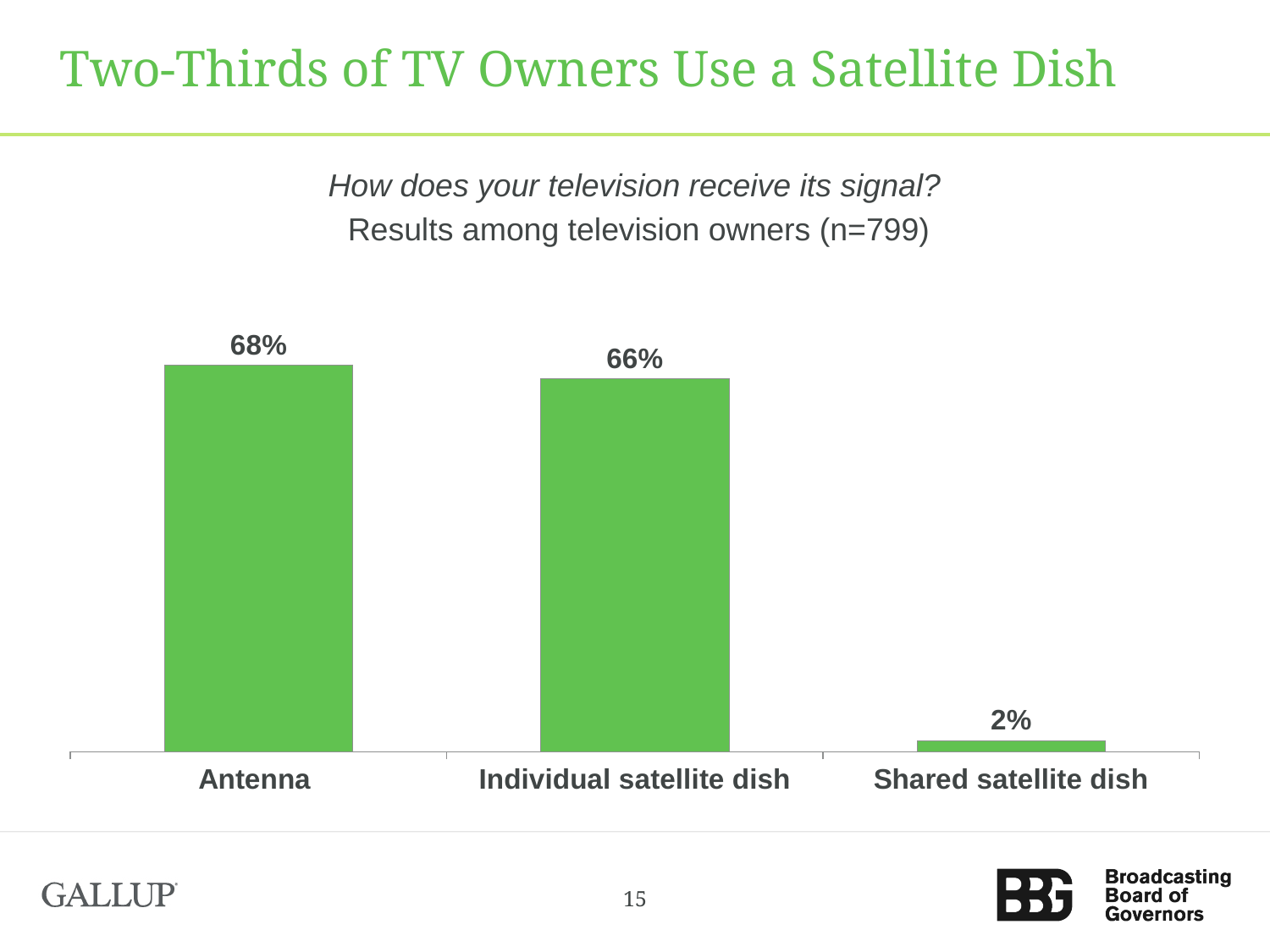
What percentage of television owners receive their signal via an antenna? 68% What kind of chart is shown on the slide? Bar chart What percentage of television owners use a shared satellite dish? 2% Which category has the lowest value? Shared satellite dish Which is larger: the value for Individual satellite dish or the value for Shared satellite dish? Individual satellite dish What is the difference between the Individual satellite dish value and the Shared satellite dish value? 64% How many categories are shown in the chart? 3 What survey question is shown above the chart? How does your television receive its signal? What percentage of television owners use an individual satellite dish? 66% Which category has the highest value? Antenna What is the difference between the Antenna value and the Individual satellite dish value? 2% What is the sample size (n) stated in the chart subtitle? 799